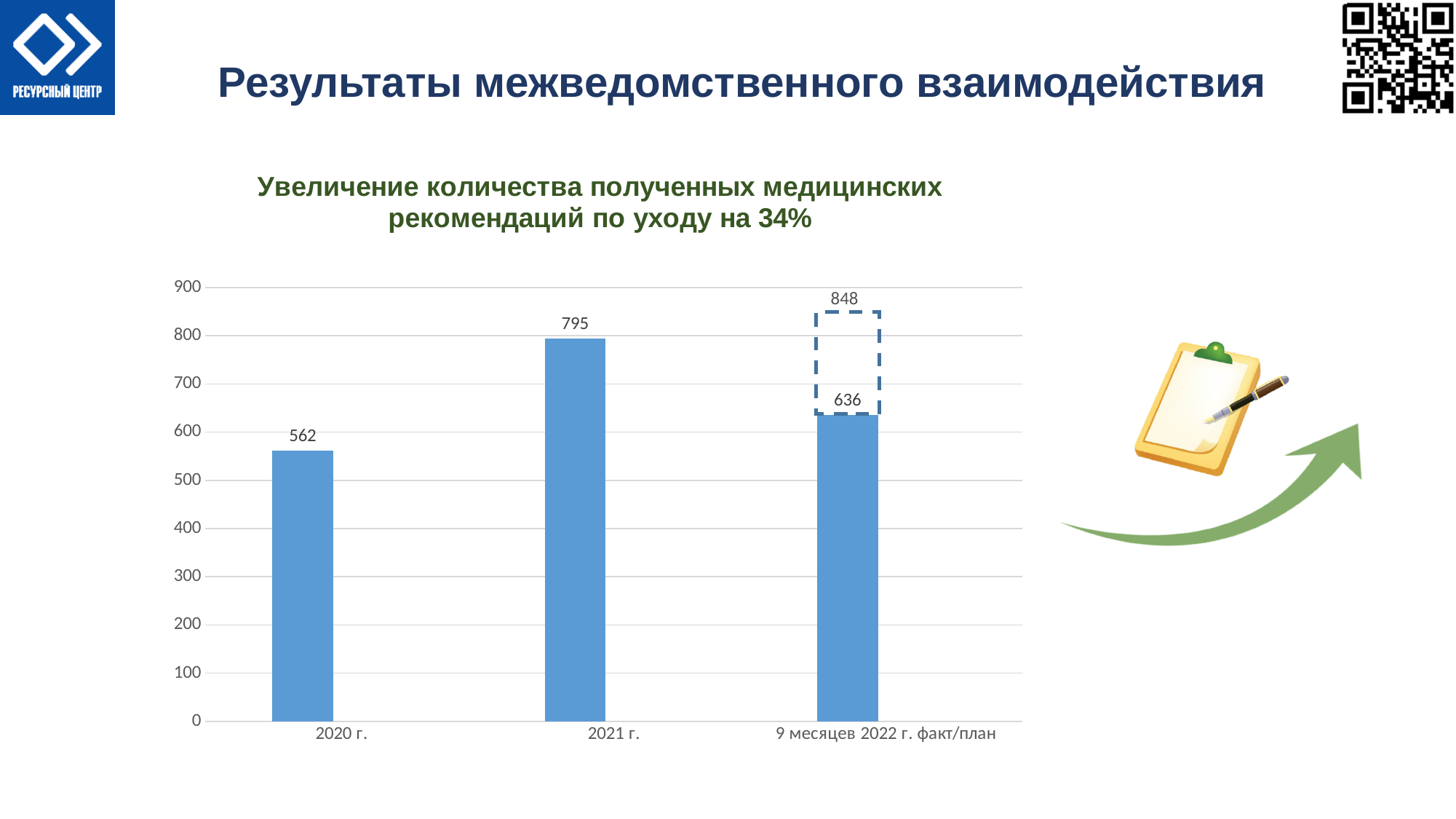
What is the difference between the plan and the actual value for 9 месяцев 2022 г.? 212 Which year has the highest solid bar? 2021 г. How many categories are shown on the x axis? 3 What is the difference between the values for 2021 г. and 2020 г.? 233 What is the actual (факт) value shown for 9 месяцев 2022 г.? 636 Which is larger, the value for 2021 г. or the actual value for 9 месяцев 2022 г.? 2021 г. By what percentage does the chart heading say the number of medical care recommendations increased? 34% Which category has the lowest value? 2020 г. What is the value for 2021 г.? 795 What is the planned (план) value shown for 9 месяцев 2022 г.? 848 What kind of chart is shown on the slide? Bar chart What is the value for 2020 г.? 562